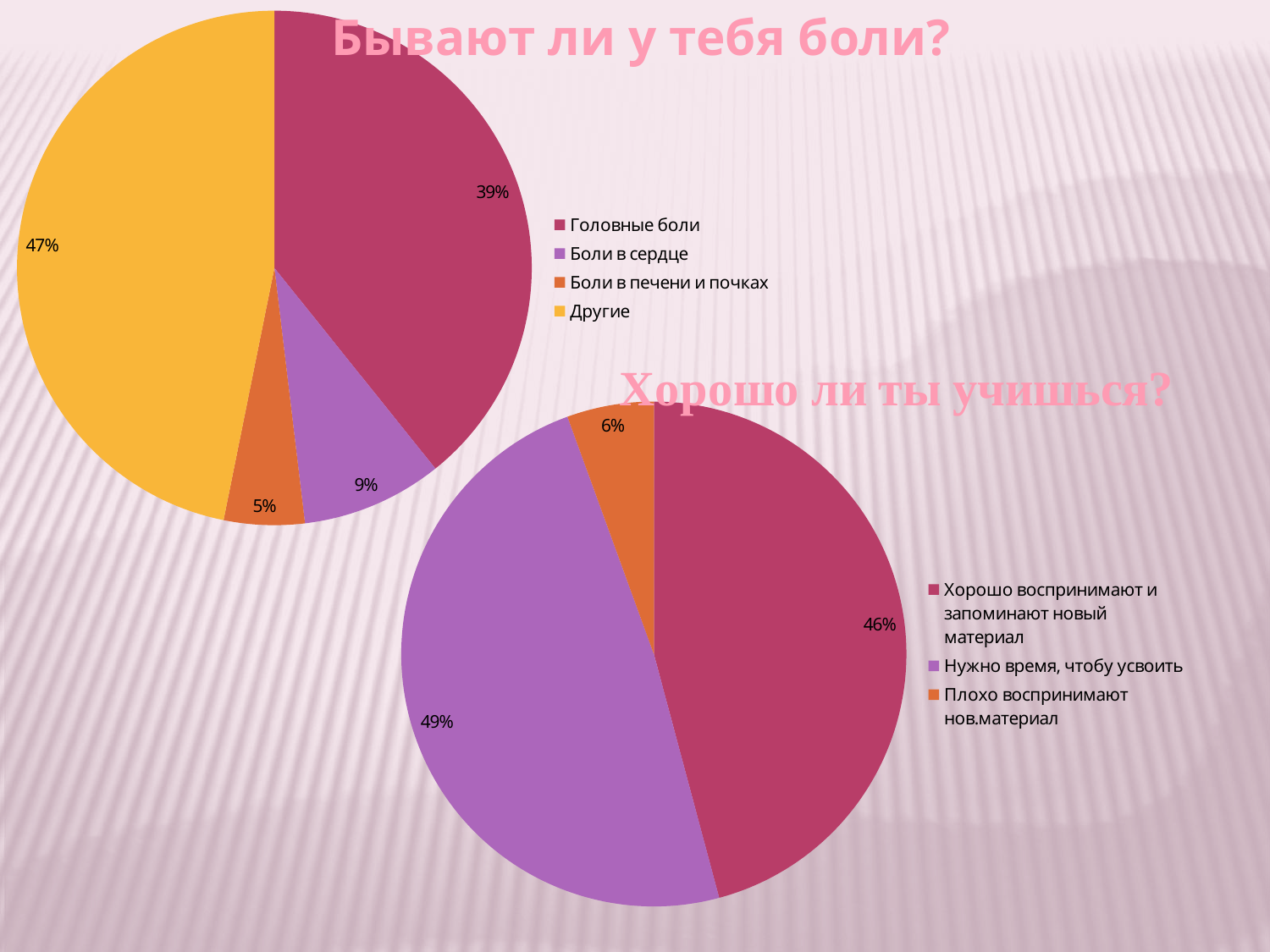
In the chart titled "Бывают ли у тебя боли?", what percentage is shown for "Боли в печени и почках"? 5% In the chart titled "Бывают ли у тебя боли?", which category has the smallest share? Боли в печени и почках In the chart titled "Бывают ли у тебя боли?", how many categories does the legend list? 4 In the chart titled "Хорошо ли ты учишься?", how many categories does the legend list? 3 In the chart titled "Бывают ли у тебя боли?", what percentage is shown for "Головные боли"? 39% In the chart titled "Бывают ли у тебя боли?", which category has the largest share? Другие In the chart titled "Хорошо ли ты учишься?", what is the difference between the shares for "Нужно время, чтобы усвоить" and "Плохо воспринимают нов.материал"? 43% In the chart titled "Бывают ли у тебя боли?", what is the difference between the shares for "Другие" and "Головные боли"? 8% In the chart titled "Хорошо ли ты учишься?", what percentage is shown for "Плохо воспринимают нов.материал"? 6% In the chart titled "Хорошо ли ты учишься?", what percentage is shown for "Нужно время, чтобы усвоить"? 49% What type of chart is the one titled "Бывают ли у тебя боли?"? Pie chart In the chart titled "Хорошо ли ты учишься?", which is larger: "Хорошо воспринимают и запоминают новый материал" or "Нужно время, чтобы усвоить"? Нужно время, чтобы усвоить